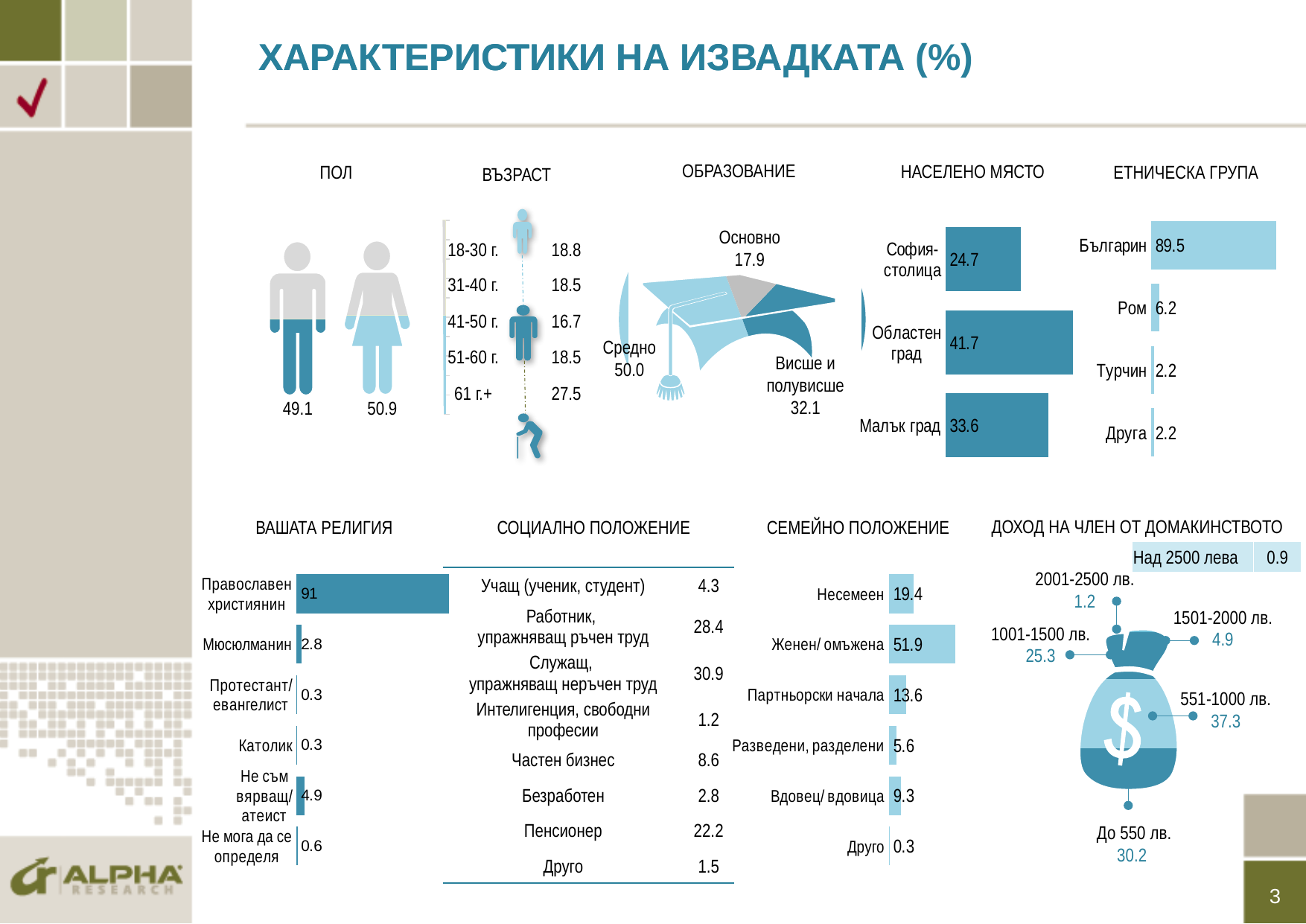
In the ВАШАТА РЕЛИГИЯ chart, what is the value for Не съм вярващ/атеист? 4.9 In the СЕМЕЙНО ПОЛОЖЕНИЕ chart, which is larger, Несемеен or Партньорски начала? Несемеен In the НАСЕЛЕНО МЯСТО chart, what is the value for Областен град? 41.7 In the НАСЕЛЕНО МЯСТО chart, which category has the lowest value? София-столица In the ДОХОД НА ЧЛЕН ОТ ДОМАКИНСТВОТО chart, what is the value for 551-1000 лв.? 37.3 In the ЕТНИЧЕСКА ГРУПА chart, what is the value for Ром? 6.2 In the ЕТНИЧЕСКА ГРУПА chart, what is the difference between Българин and Ром? 83.3 In the ВЪЗРАСТ chart, which age group has the highest value? 61 г.+ In the ВЪЗРАСТ chart, what is the value for 41-50 г.? 16.7 In the ОБРАЗОВАНИЕ chart, what is the value for Средно? 50.0 In the ЕТНИЧЕСКА ГРУПА chart, how many categories are shown? 4 What kind of chart is the ОБРАЗОВАНИЕ chart? pie chart